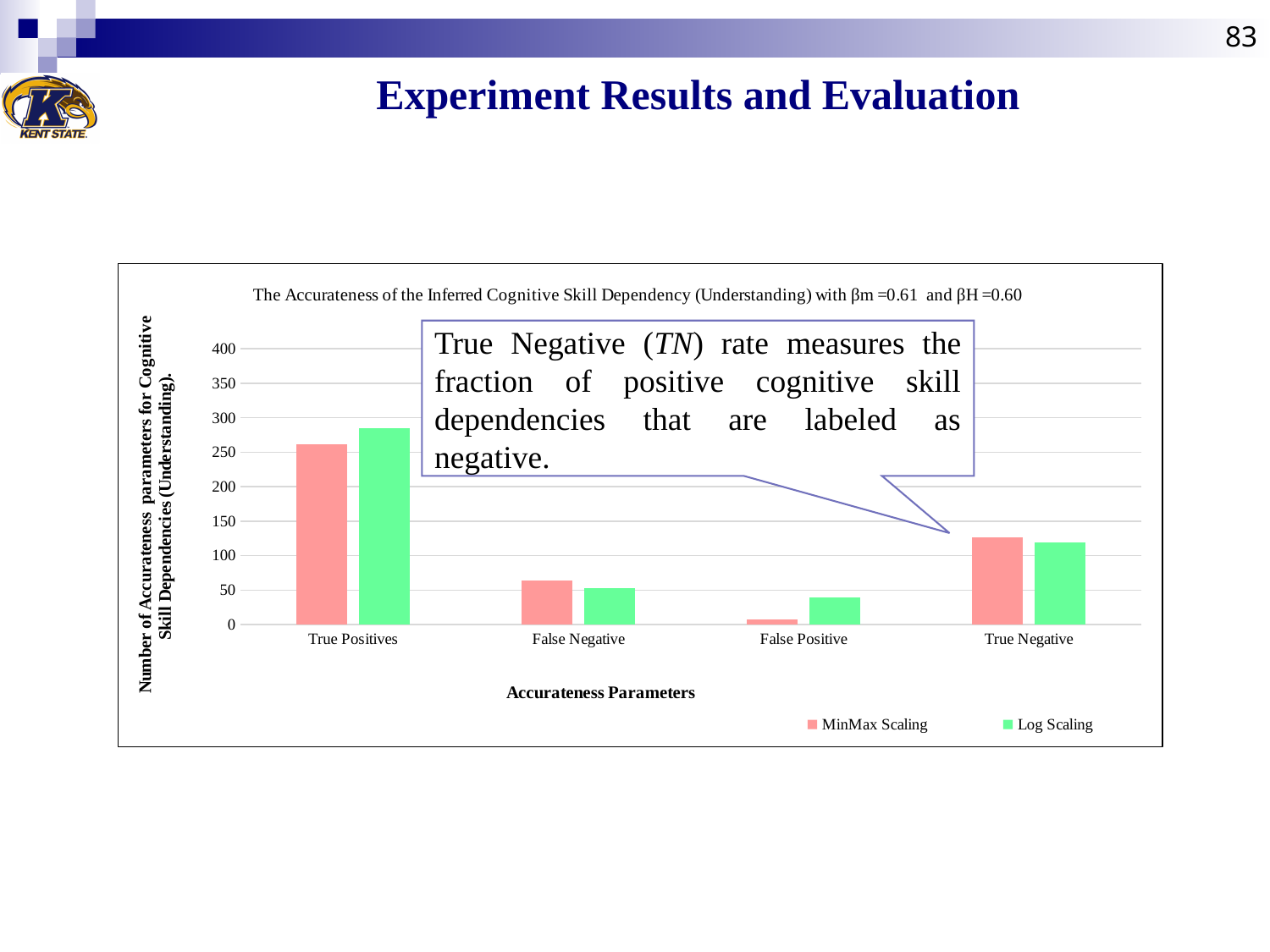
What is the x-axis title of the chart? Accurateness Parameters How many series does the chart's legend list? 2 For the Log Scaling series, which category has the highest value? True Positives For False Negative, which series has the larger value, MinMax Scaling or Log Scaling? MinMax Scaling Which two series are listed in the chart's legend? MinMax Scaling and Log Scaling What kind of chart is shown on the slide? bar chart How many categories are shown on the x axis of the chart? 4 For True Positives, which series has the larger value, MinMax Scaling or Log Scaling? Log Scaling Is the Log Scaling value for False Positive greater or less than 50? less Is the MinMax Scaling value for True Positives greater or less than 250? greater For False Positive, which series has the larger value, MinMax Scaling or Log Scaling? Log Scaling For the MinMax Scaling series, which category has the lowest value? False Positive